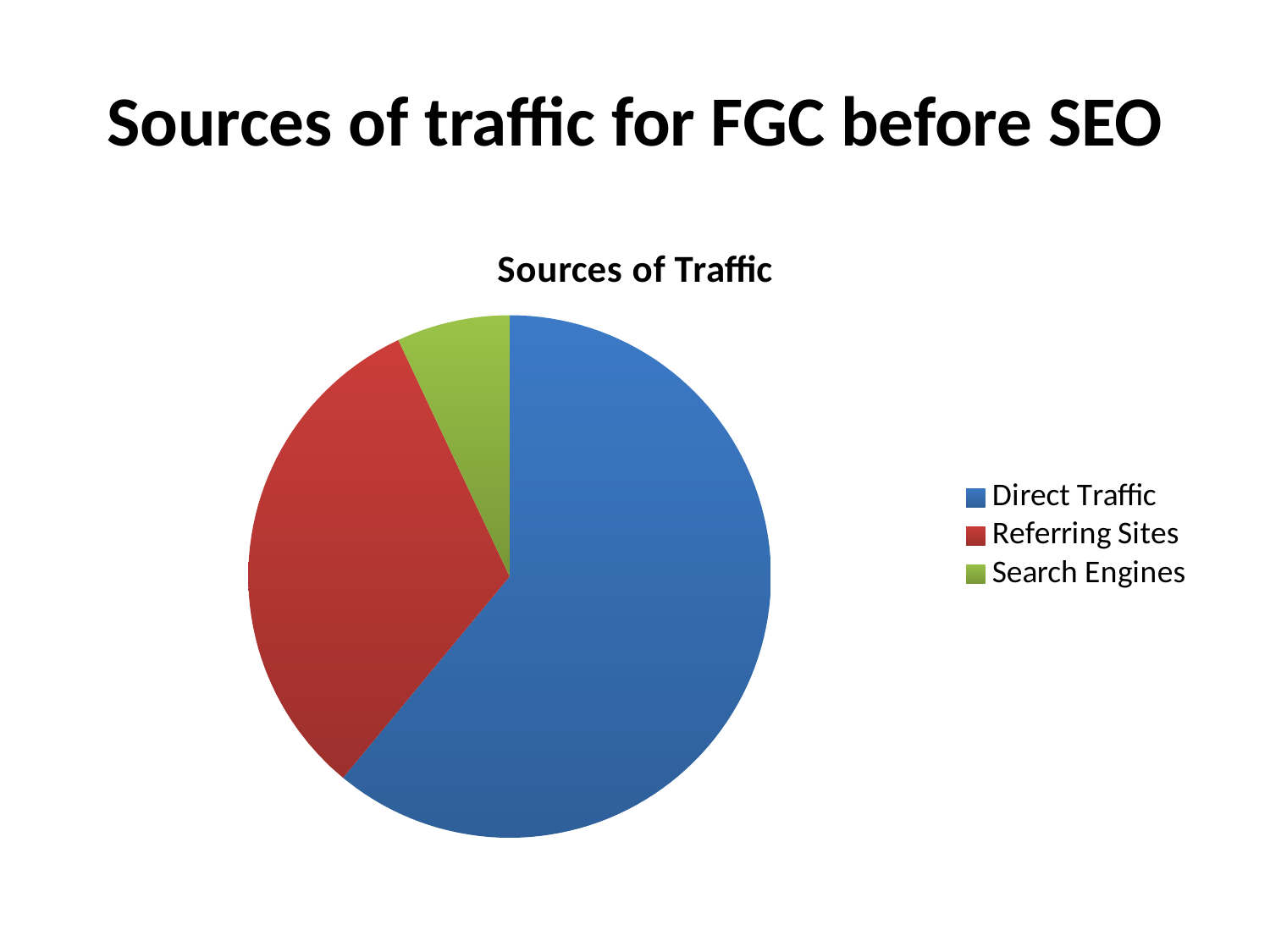
Which traffic source has the smallest slice of the pie? Search Engines Which colour represents Search Engines in the pie chart? green Which slice is larger, Referring Sites or Search Engines? Referring Sites Which slice is larger, Direct Traffic or Referring Sites? Direct Traffic How many entries does the legend list? 3 How many slices does the pie chart have? 3 What is the title of the chart? Sources of Traffic Does Direct Traffic account for more or less than half of the pie? more What kind of chart is shown on the slide? pie chart Which traffic source has the largest slice of the pie? Direct Traffic